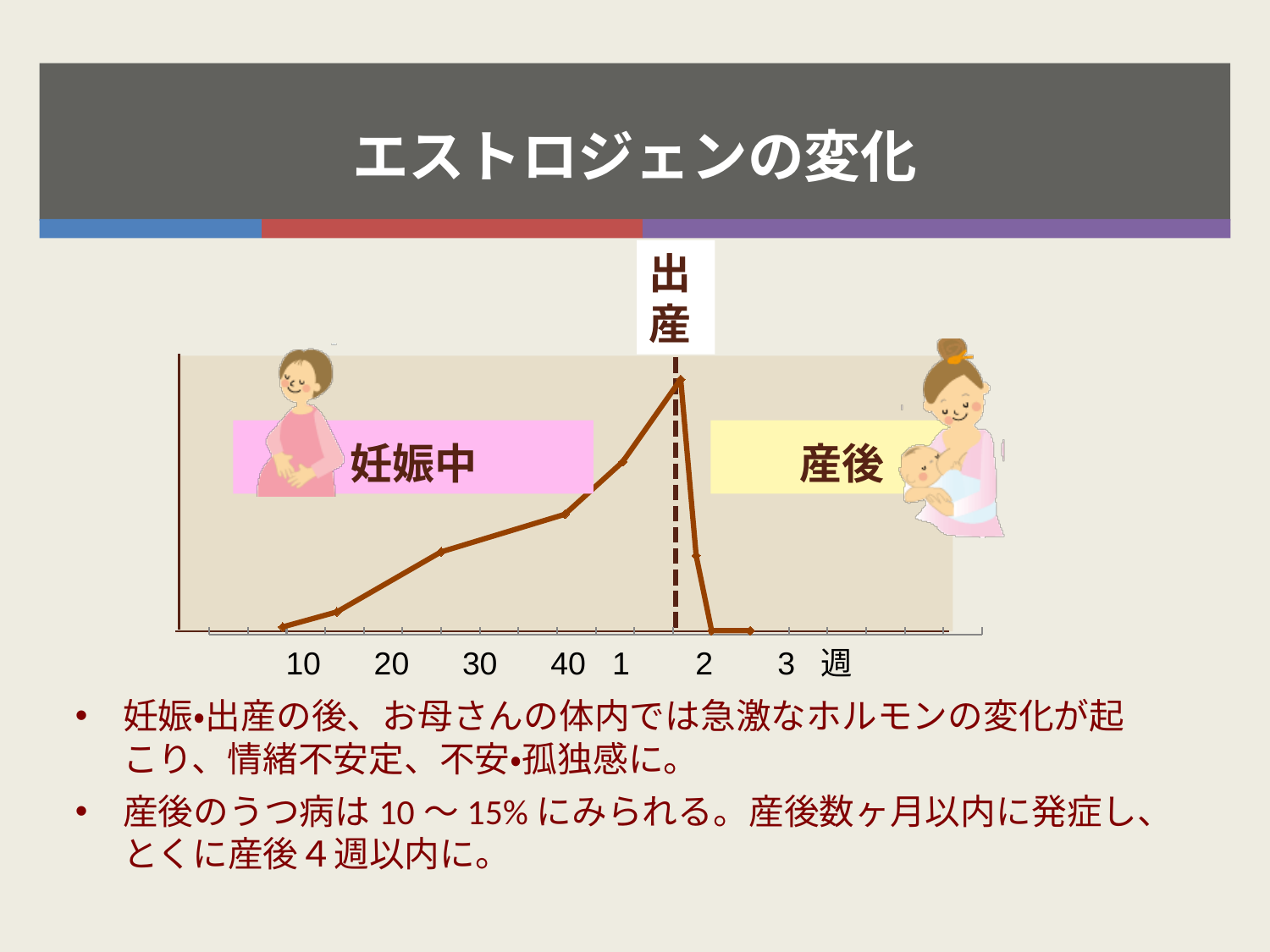
Which is larger, the value at 40 weeks of pregnancy or the value at 10 weeks of pregnancy? 40 weeks What unit is written at the end of the x axis? 週 At which point on the x axis does the line reach its highest value? 出産 (birth) Which is larger, the value at 40 weeks of pregnancy or the value at 3 weeks after birth? 40 weeks of pregnancy How many numeric tick labels are shown on the x axis? 7 How do the values change along the x axis after 出産 (birth)? They fall sharply What does the vertical dashed line in the chart mark? 出産 Which is larger, the value at 30 weeks of pregnancy or the value at 20 weeks of pregnancy? 30 weeks What is the title of the slide/chart? エストロジェンの変化 How do the values change along the x axis during the 妊娠中 (pregnancy) period? They rise What kind of chart is shown on the slide? line chart